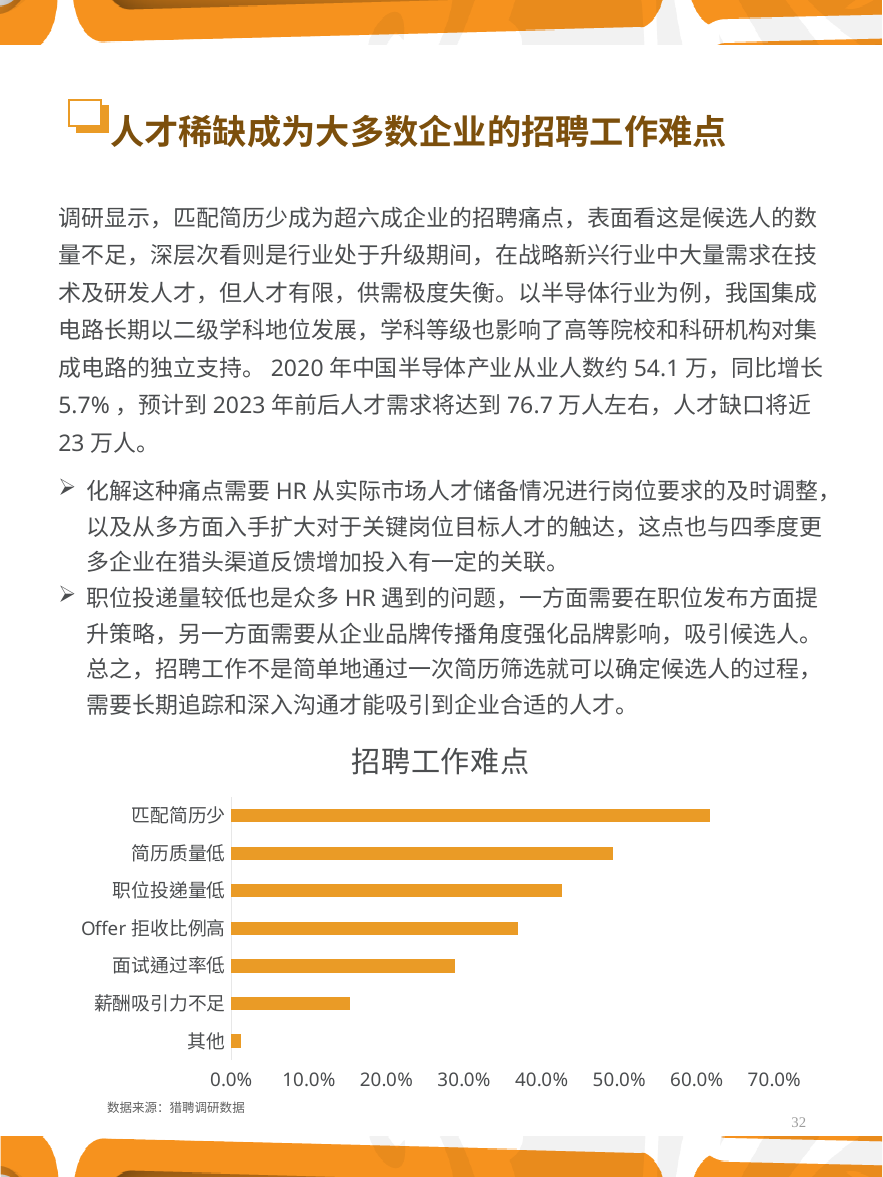
Is the value for Offer 拒收比例高 greater or less than 30.0%? greater Which category has the lowest value in the 招聘工作难点 chart? 其他 How many categories are plotted in the 招聘工作难点 chart? 7 Is the value for 匹配简历少 greater or less than 50.0%? greater Is the value for 其他 greater or less than 10.0%? less What kind of chart is shown under the title 招聘工作难点? bar chart Which category has the highest value in the 招聘工作难点 chart? 匹配简历少 Which is larger, the value for 简历质量低 or the value for 面试通过率低? 简历质量低 What is the title of the chart on the slide? 招聘工作难点